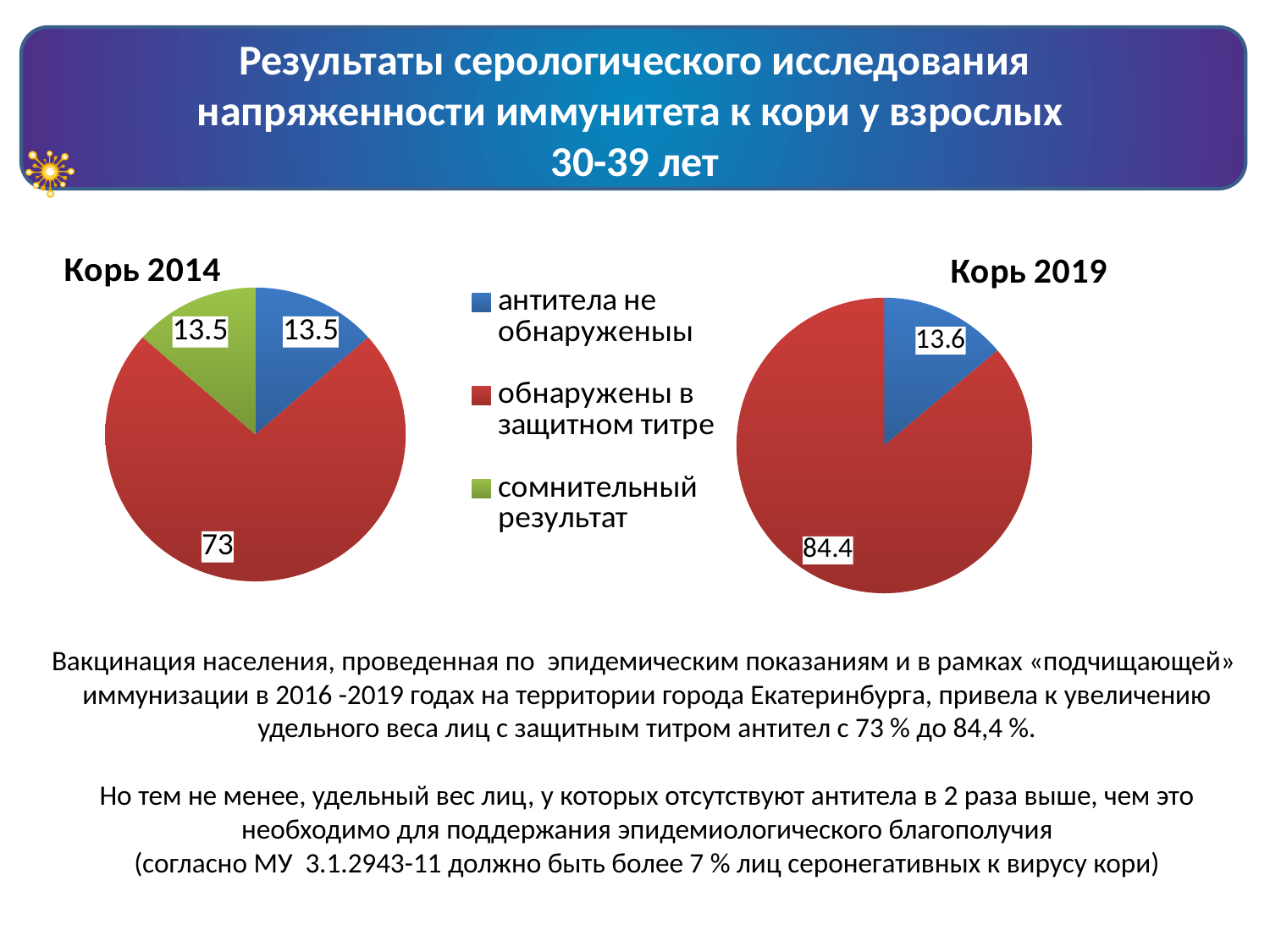
Which is larger: the "обнаружены в защитном титре" value in the "Корь 2014" chart or in the "Корь 2019" chart? Корь 2019 What type of chart is the "Корь 2014" chart? pie chart In the "Корь 2019" chart, what is the value for "антитела не обнаружены"? 13.6 What is the difference between the "обнаружены в защитном титре" values in the "Корь 2019" and "Корь 2014" charts? 11.4 How many entries does the legend between the two charts list? 3 How many slices does the "Корь 2014" chart have? 3 In the "Корь 2014" chart, what is the value for "сомнительный результат"? 13.5 In the "Корь 2019" chart, what is the value for "обнаружены в защитном титре"? 84.4 In the "Корь 2014" chart, which category has the largest slice? обнаружены в защитном титре In the "Корь 2019" chart, which category has the smallest slice? антитела не обнаружены How many slices does the "Корь 2019" chart have? 2 In the "Корь 2014" chart, what is the value for "обнаружены в защитном титре"? 73